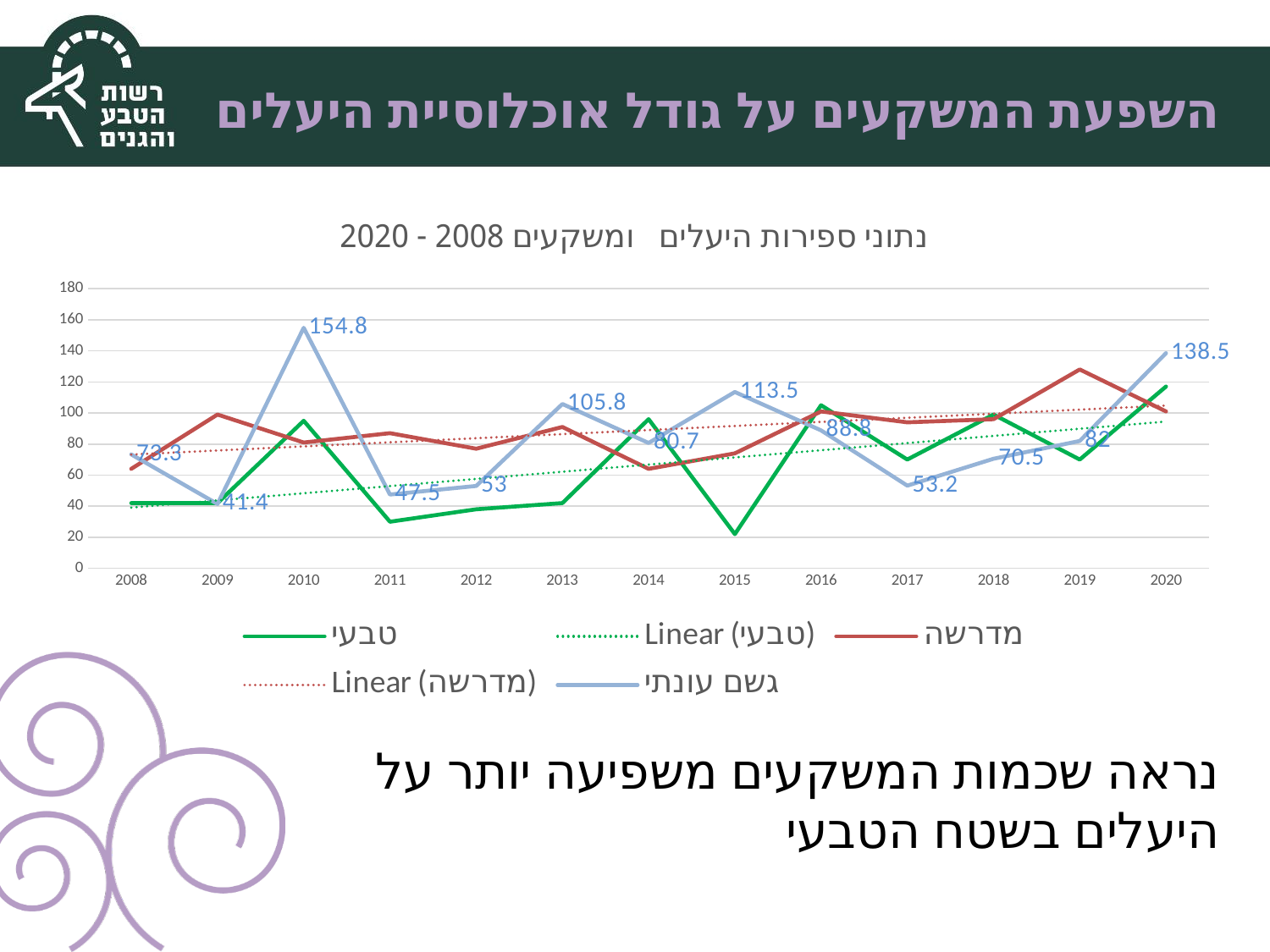
What is the value of גשם עונתי in 2010? 154.8 What type of chart is shown on the slide? line chart What is the difference between the גשם עונתי values for 2010 and 2009? 113.4 Is the value for מדרשה in 2019 greater or less than 120? greater How many entries does the legend list? 5 What is the value of גשם עונתי in 2017? 53.2 How many years are shown on the x axis? 13 What is the value of גשם עונתי in 2020? 138.5 Is the value for טבעי in 2015 greater or less than 40? less In which year is גשם עונתי highest? 2010 Which is larger for גשם עונתי: the value in 2013 or the value in 2015? 2015 In which year is גשם עונתי lowest? 2009